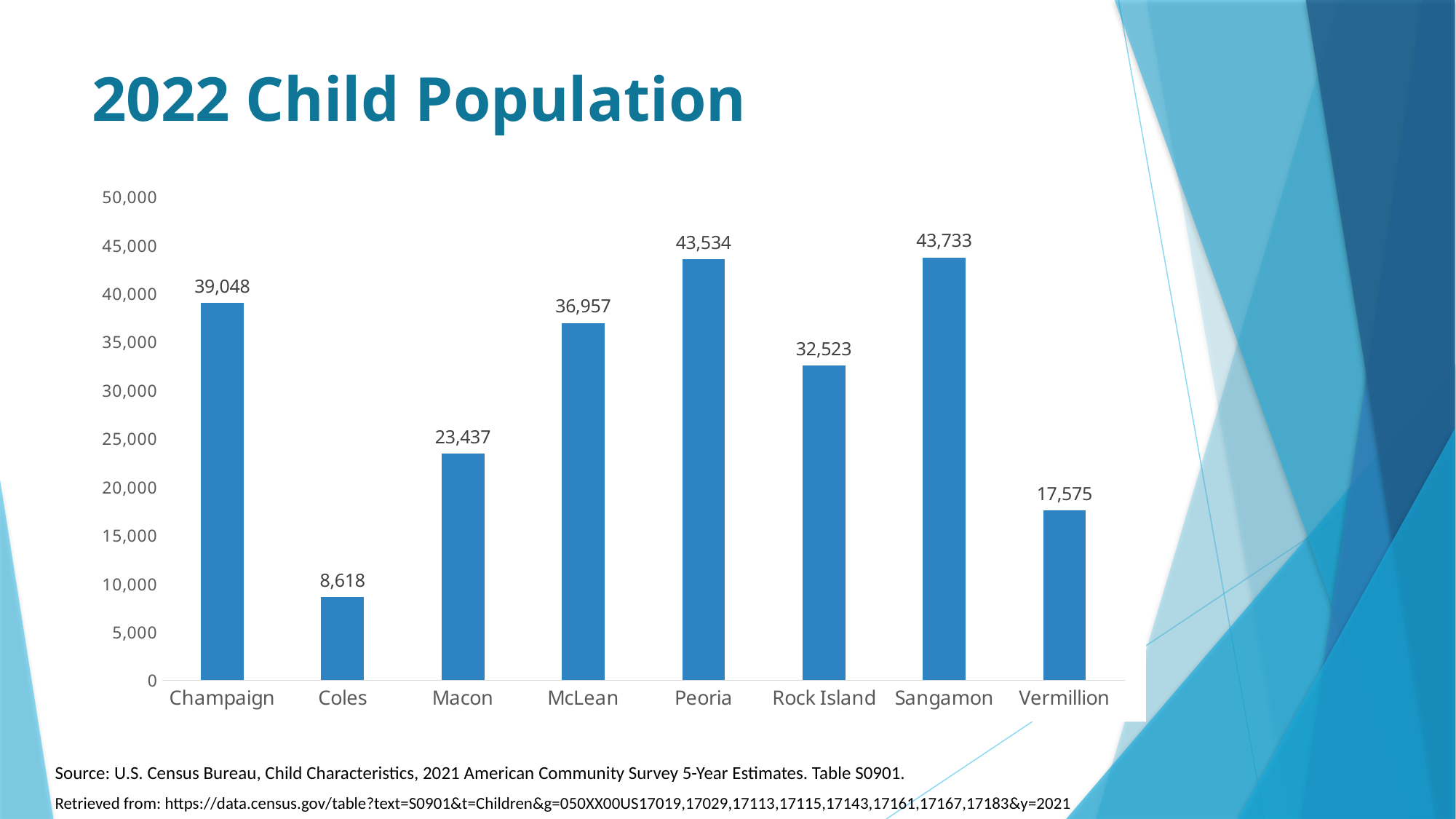
Which county has the lowest child population in the chart? Coles What is the difference between the values for Champaign and Coles? 30,430 What is the difference between the values for Peoria and Rock Island? 11,011 Which county has the highest child population in the chart? Sangamon What is the value shown for Rock Island? 32,523 What kind of chart is shown on the slide? Bar chart What is the title of the slide? 2022 Child Population Is the value for Macon greater or less than 25,000? less What is the value shown for Vermillion? 17,575 How many counties are shown in the chart? 8 Which has a larger child population, McLean or Macon? McLean What is the 2022 child population shown for Champaign? 39,048